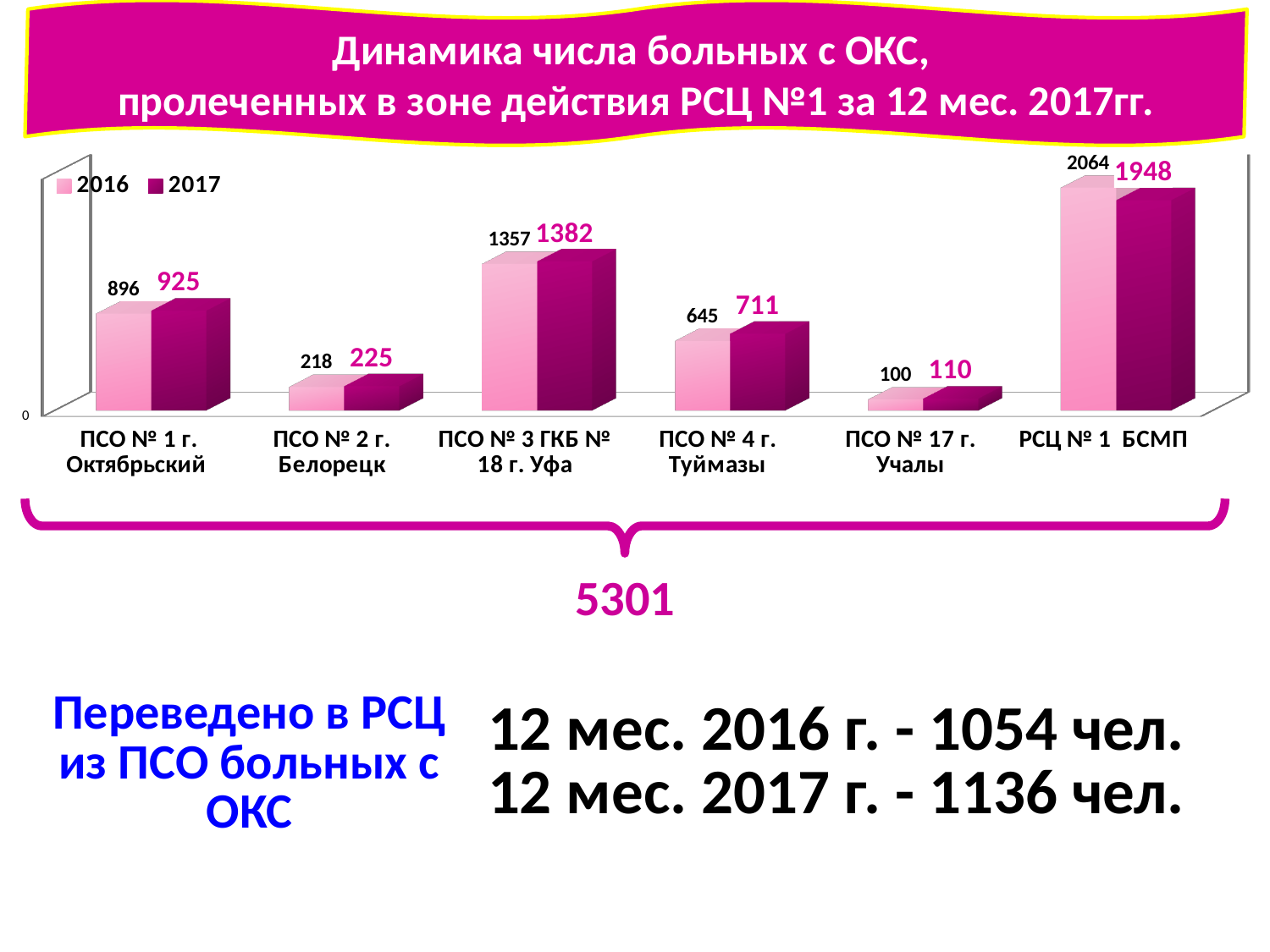
What is the 2016 value for ПСО № 4 г. Туймазы? 645 How many series does the legend list? 2 Which series is shown in the darker magenta colour? 2017 Which category has the lowest 2016 value? ПСО № 17 г. Учалы What is the difference between the 2016 and 2017 values for РСЦ № 1 БСМП? 116 What is the 2017 value for ПСО № 3 ГКБ № 18 г. Уфа? 1382 What kind of chart is shown on the slide? bar chart What is the 2016 value for РСЦ № 1 БСМП? 2064 How many categories are shown on the x axis? 6 Which category has the highest 2017 value? РСЦ № 1 БСМП What is the difference between the 2017 and 2016 values for ПСО № 4 г. Туймазы? 66 Which is larger for ПСО № 1 г. Октябрьский: the 2016 value or the 2017 value? 2017